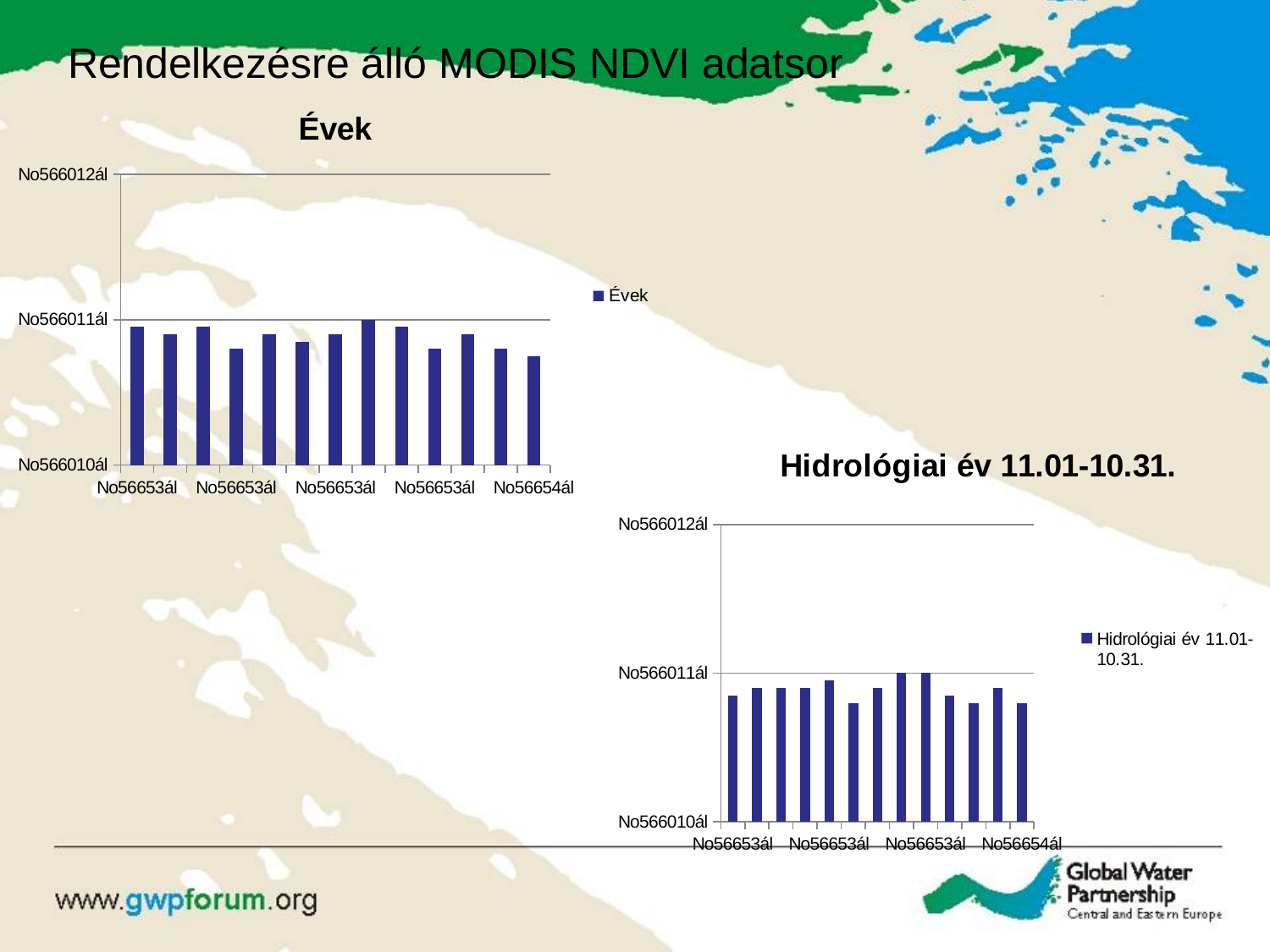
How many bars are plotted in the "Évek" chart? 13 What kind of chart is the chart titled "Évek"? bar chart What kind of chart is the chart titled "Hidrológiai év 11.01-10.31."? bar chart In the "Évek" chart, which bar is the shortest, counting from the left? the 13th (last) bar In the "Évek" chart, which bar is the tallest, counting from the left? the 8th bar What is the title of the chart in the upper left of the slide? Évek How many charts are shown on the slide? 2 How many bars are plotted in the "Hidrológiai év 11.01-10.31." chart? 13 How many series does the legend of the "Évek" chart list? 1 How many series does the legend of the "Hidrológiai év 11.01-10.31." chart list? 1 What is the title of the chart in the lower right of the slide? Hidrológiai év 11.01-10.31. In the "Évek" chart, is the 8th bar from the left taller or shorter than the 13th bar? taller